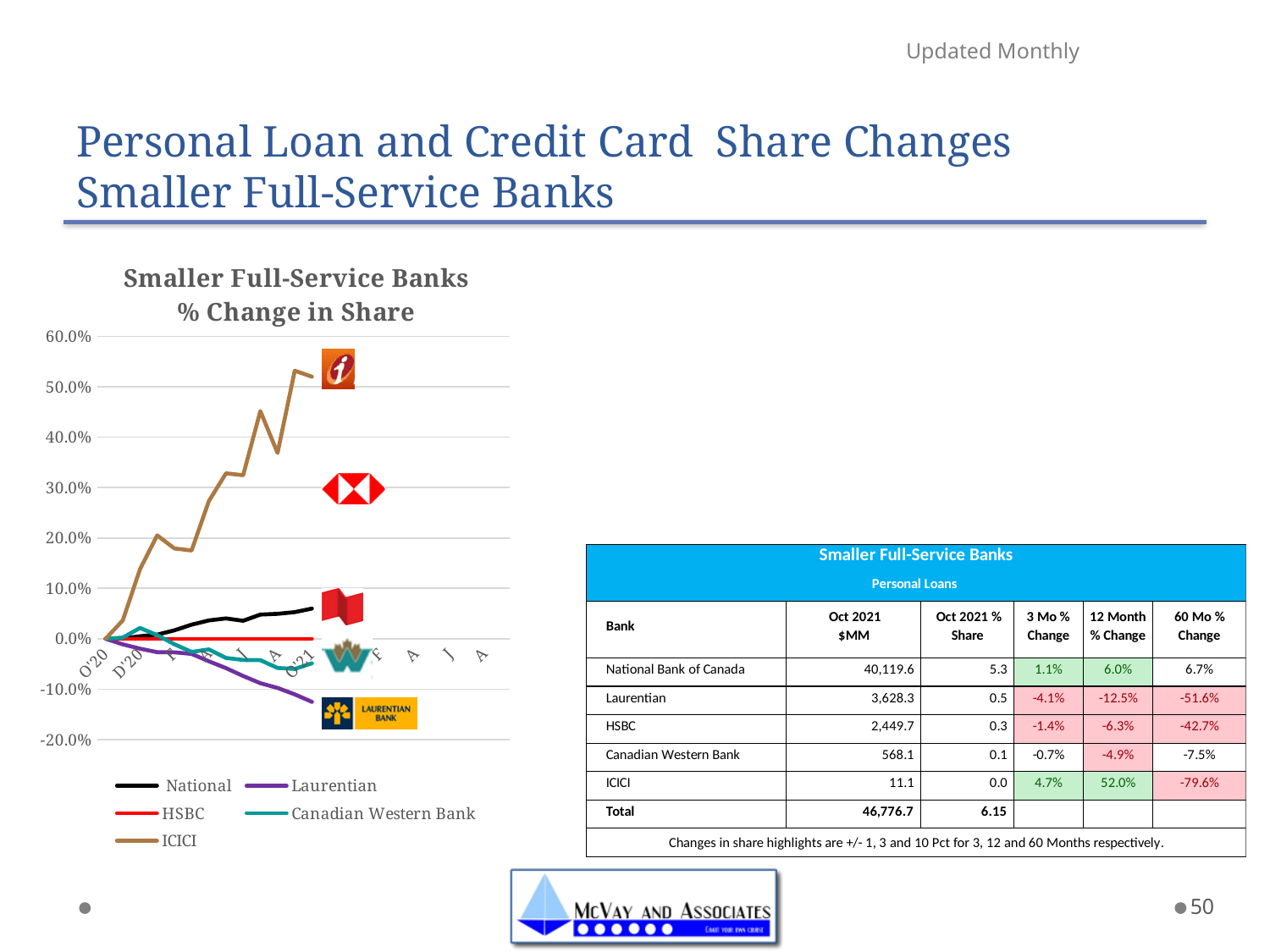
At the end of the period, which is larger: the value for ICICI or the value for National? ICICI What colour is the line for HSBC in the chart? red Is the final value for Laurentian greater or less than -10.0%? less Which series reaches the lowest value on the chart? Laurentian Does the ICICI line rise or fall along the x axis? rise How many series does the legend of the chart list? 5 Is the final value for National greater or less than 0.0%? greater What is the title of the chart? Smaller Full-Service Banks % Change in Share Is the final value for ICICI greater or less than 40.0%? greater Which series reaches the highest value on the chart? ICICI Does the Laurentian line rise or fall along the x axis? fall What kind of chart is shown on the slide? line chart